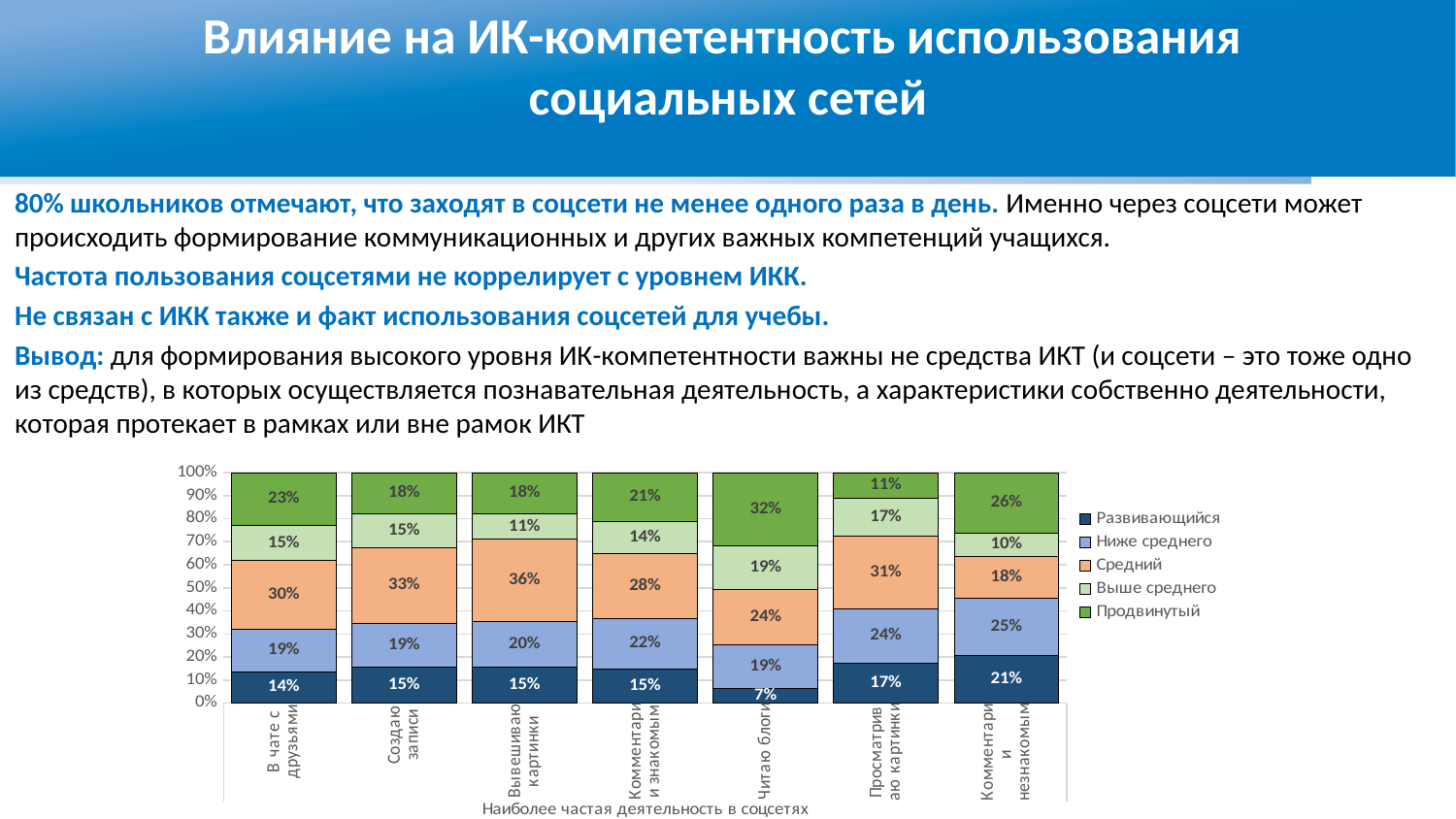
Which category has the lowest value for the "Развивающийся" series? Читаю блоги Which legend entry is shown in green at the top of each bar? Продвинутый What is the value of the "Продвинутый" series for "Читаю блоги"? 32% What is the value of the "Средний" series for "Вывешиваю картинки"? 36% Which is larger: the "Ниже среднего" value for "Комментарии незнакомым" or for "В чате с друзьями"? Комментарии незнакомым What is the difference between the "Средний" values for "Вывешиваю картинки" and "Комментарии незнакомым"? 18% What is the value of the "Развивающийся" series for "Читаю блоги"? 7% What is the x-axis title of the chart? Наиболее частая деятельность в соцсетях How many categories are shown on the x axis of the chart? 7 How many series does the chart legend list? 5 What kind of chart is shown on the slide? stacked bar chart Which category has the highest value for the "Продвинутый" series? Читаю блоги